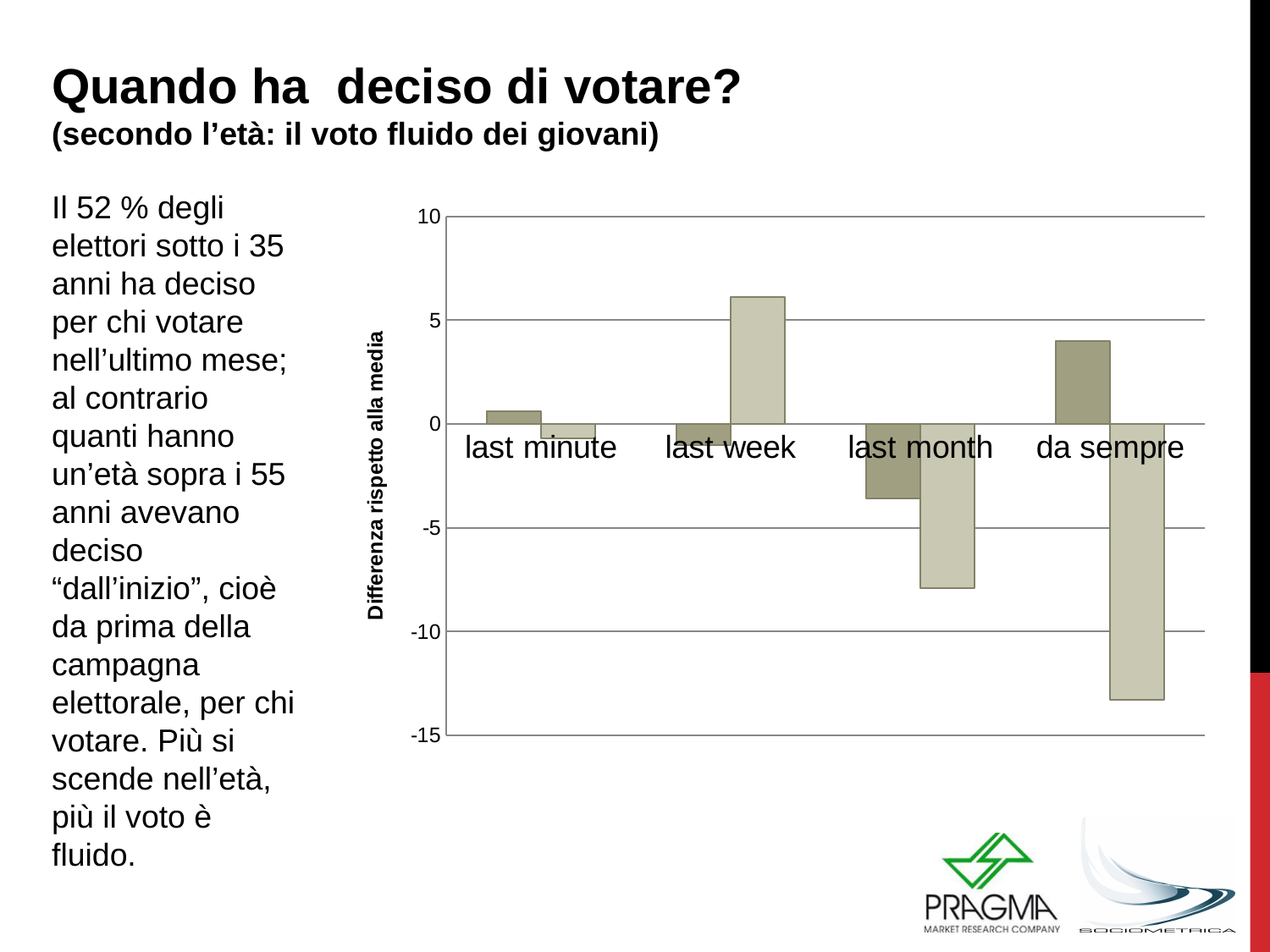
Is the value of the darker bar for "da sempre" greater or less than 0? greater Is the value of the lighter bar for "last month" greater or less than -5? less Is the value of the lighter bar for "da sempre" greater or less than -10? less What is the label of the vertical axis of the chart? Differenza rispetto alla media Which category has the bar that reaches the highest value in the chart? last week What kind of chart is shown on the slide? bar chart Which category has the bar that reaches the lowest value in the chart? da sempre For the category "last week", which bar is larger, the darker bar or the lighter bar? the lighter bar How many categories are shown on the x axis of the chart? 4 What is the lowest value shown on the vertical axis of the chart? -15